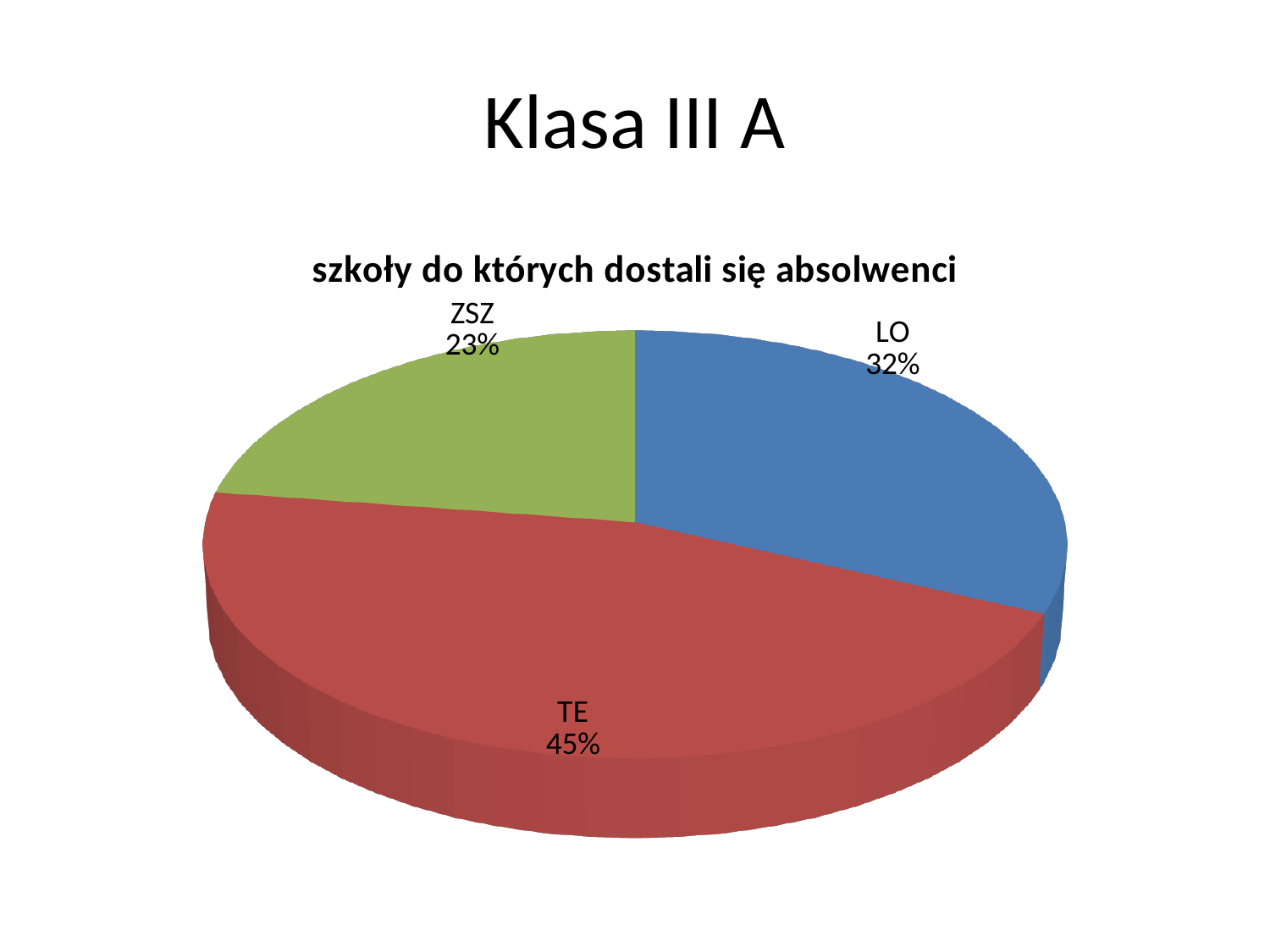
What share of the pie does LO have? 32% Which category has the smallest slice? ZSZ What is the difference in percentage points between LO and ZSZ? 9 What is the title of the chart? szkoły do których dostali się absolwenci What is the difference in percentage points between TE and LO? 13 What kind of chart is shown on the slide? pie chart How many slices does the pie chart have? 3 What share of the pie does ZSZ have? 23% What colour is the TE slice? red What share of the pie does TE have? 45% Which is larger, the share for LO or the share for ZSZ? LO Which category has the largest slice? TE